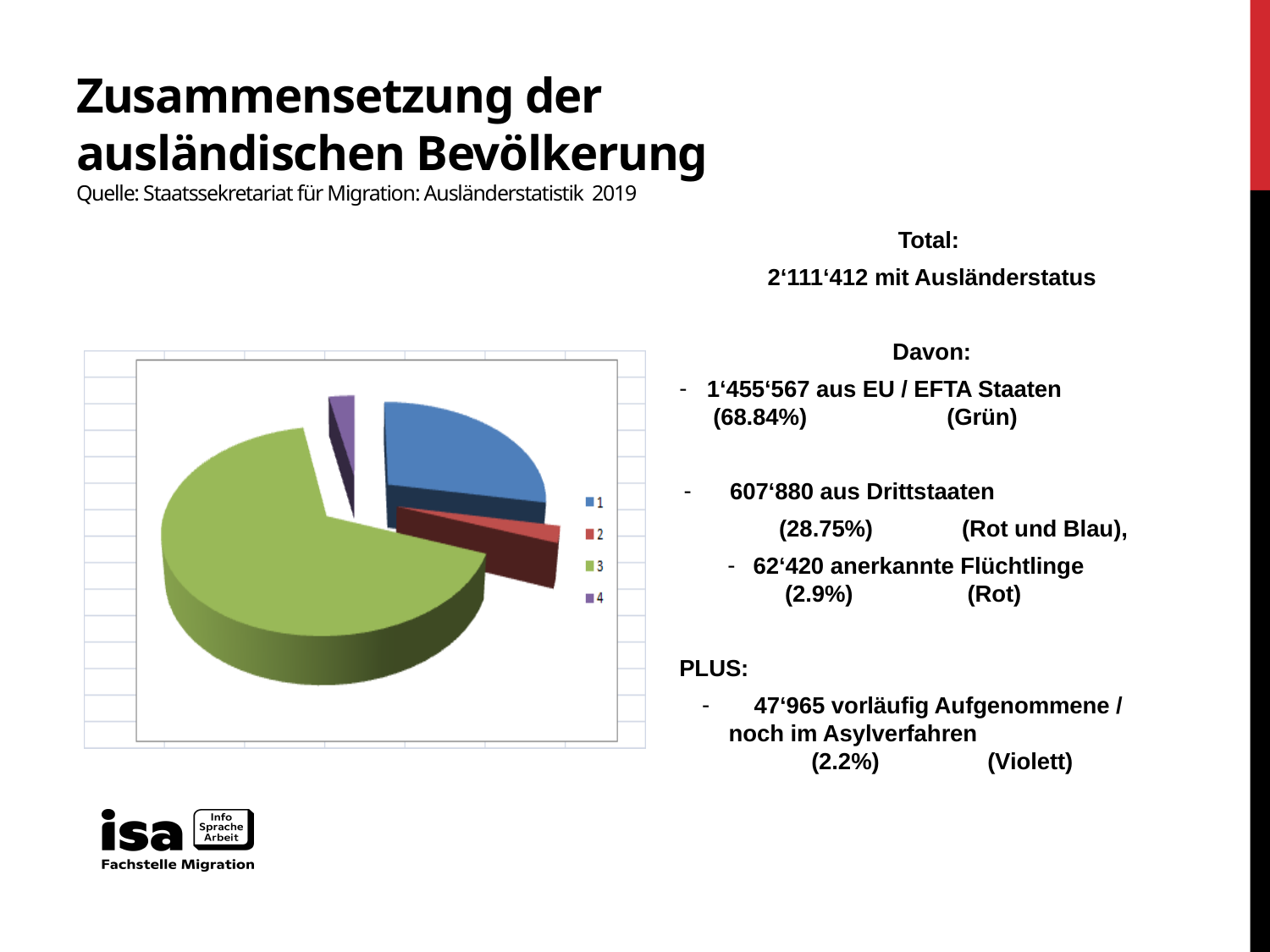
What kind of chart is shown on the slide? pie chart Which slice is larger, the green slice or the blue slice? green Which slice is larger, the blue slice (1) or the red slice (2)? blue (1) How many people from EU / EFTA Staaten are represented by the green slice? 1'455'567 Which legend entry corresponds to the largest slice of the pie chart? 3 What is the total number of people with Ausländerstatus represented by the whole pie? 2'111'412 What share of the pie does the red slice (anerkannte Flüchtlinge) represent? 2.9% What colour is the largest slice of the pie chart? green How many slices does the pie chart have? 4 What share of the pie does the green slice (EU / EFTA Staaten) represent? 68.84% How many entries does the pie chart's legend list? 4 What share of the pie does the violet slice (vorläufig Aufgenommene / noch im Asylverfahren) represent? 2.2%